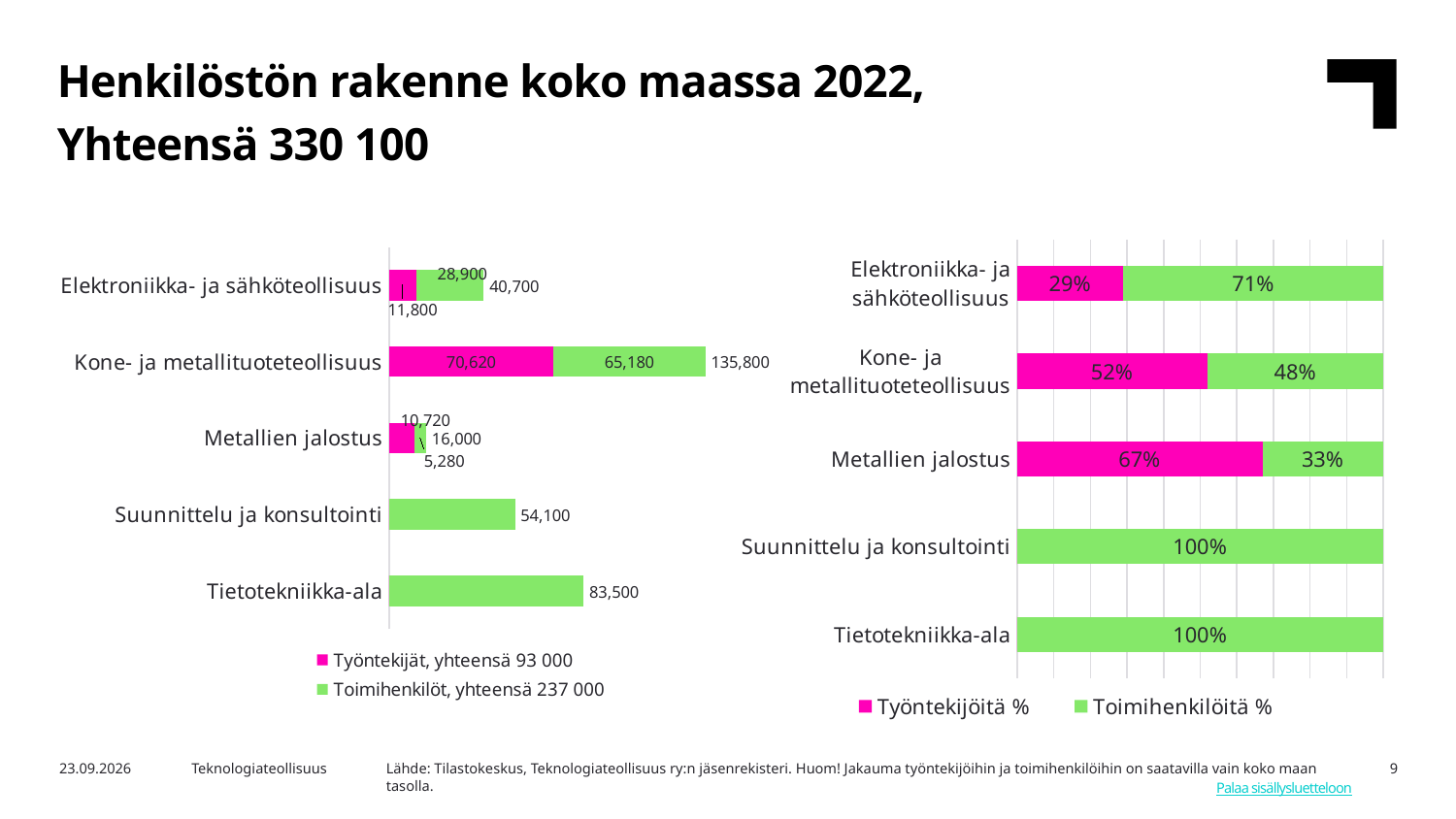
How many categories are shown in the right chart? 5 In the left chart, what is the Toimihenkilöt value for Kone- ja metallituoteteollisuus? 65,180 In the left chart, which category has the highest total? Kone- ja metallituoteteollisuus In the right chart, what is the Toimihenkilöitä % for Elektroniikka- ja sähköteollisuus? 71% What type of chart is the left chart? Stacked bar chart In the left chart, which category has the lowest total? Metallien jalostus In the left chart, which is larger for Kone- ja metallituoteteollisuus: Työntekijät or Toimihenkilöt? Työntekijät In the left chart, what is the total shown for Metallien jalostus? 16,000 In the left chart, what is the difference between the totals for Tietotekniikka-ala and Suunnittelu ja konsultointi? 29,400 In the left chart, what is the Työntekijät value for Elektroniikka- ja sähköteollisuus? 11,800 In the right chart, which category has the highest Työntekijöitä %? Metallien jalostus In the right chart, what is the Työntekijöitä % for Metallien jalostus? 67%